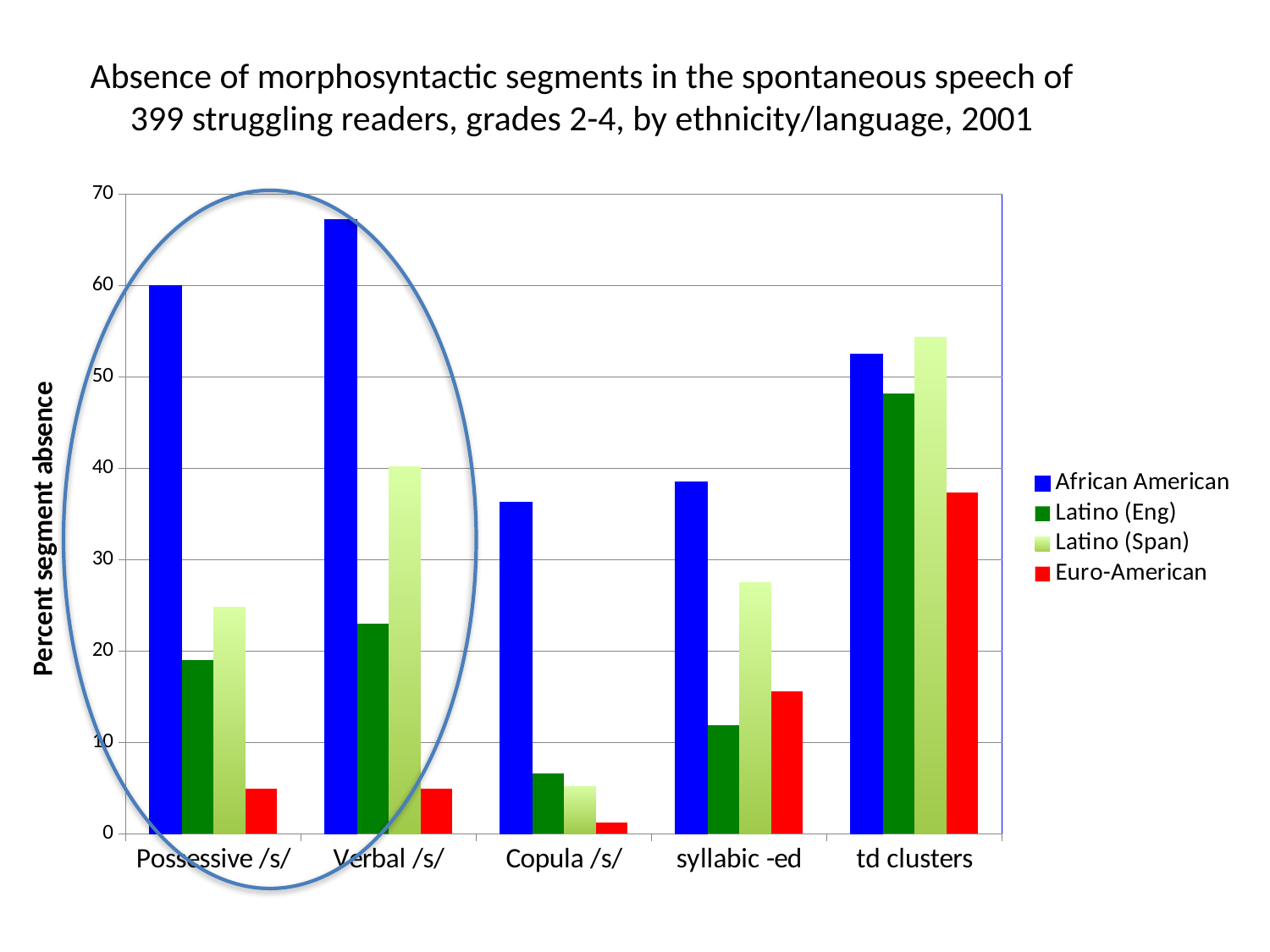
Is the value for African American in Verbal /s/ greater or less than 60? greater How many series does the legend list? 4 Which series has the lowest value for Copula /s/? Euro-American Which is larger for Possessive /s/: Latino (Eng) or Latino (Span)? Latino (Span) Is the value for Euro-American in td clusters greater or less than 30? greater Which series has the highest value for Verbal /s/? African American What is the label of the y axis? Percent segment absence Which series has the highest value for td clusters? Latino (Span) Is the value for Latino (Span) in syllabic -ed greater or less than 30? less How many categories are shown along the x axis? 5 What kind of chart is shown on the slide? bar chart Across the categories, in which category is the African American value the highest? Verbal /s/